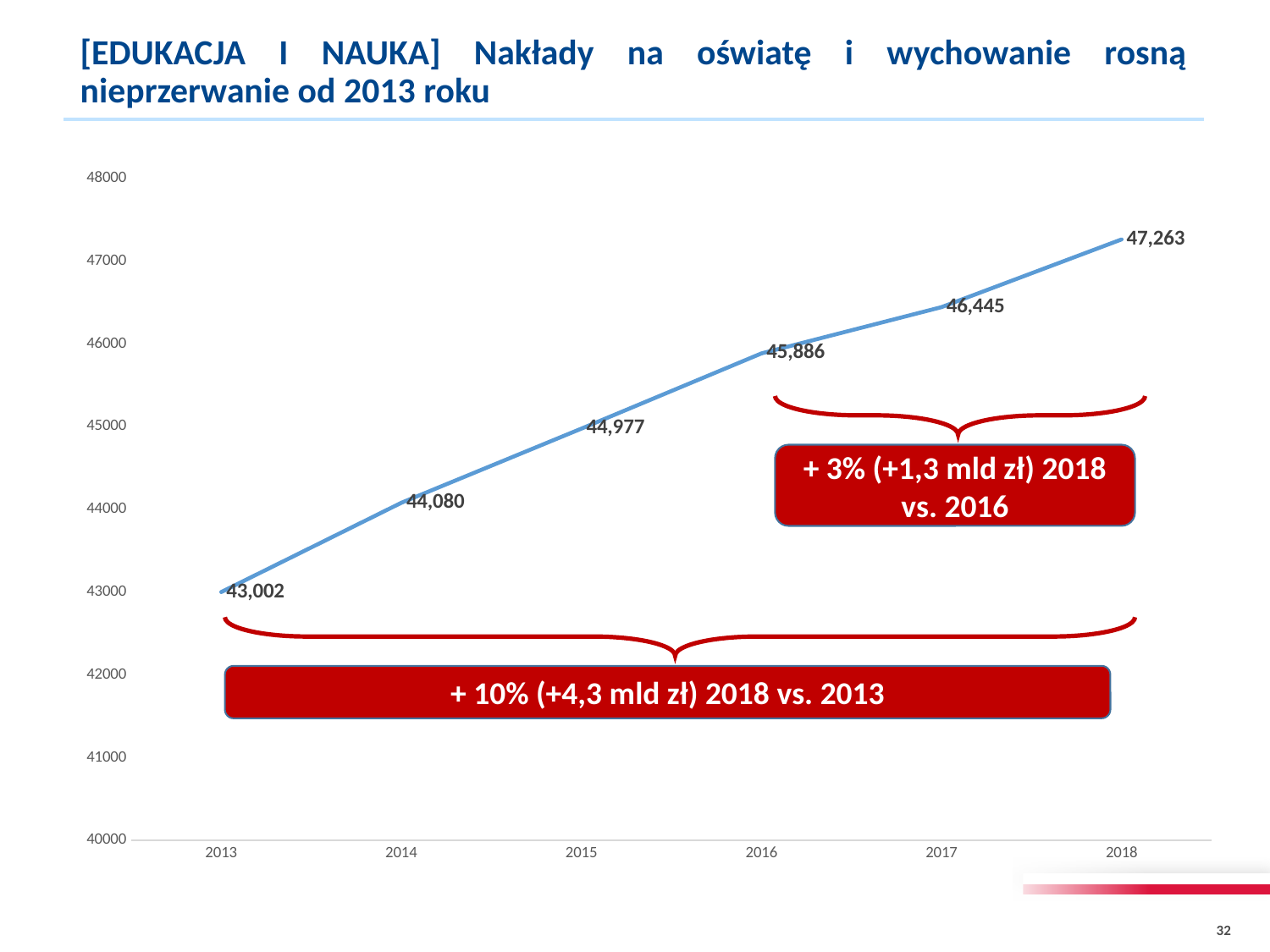
What kind of chart is shown on the slide? line chart How many years are plotted on the x axis? 6 What is the value for 2018? 47,263 What is the value for 2016? 45,886 Which year has the highest value? 2018 What is the value for 2015? 44,977 Which year has the lowest value? 2013 Is the value for 2017 greater or less than 46000? greater What is the value for 2013? 43,002 Which is larger, the value for 2014 or the value for 2017? 2017 What is the difference between the values for 2018 and 2016? 1,377 What is the difference between the values for 2018 and 2013? 4,261